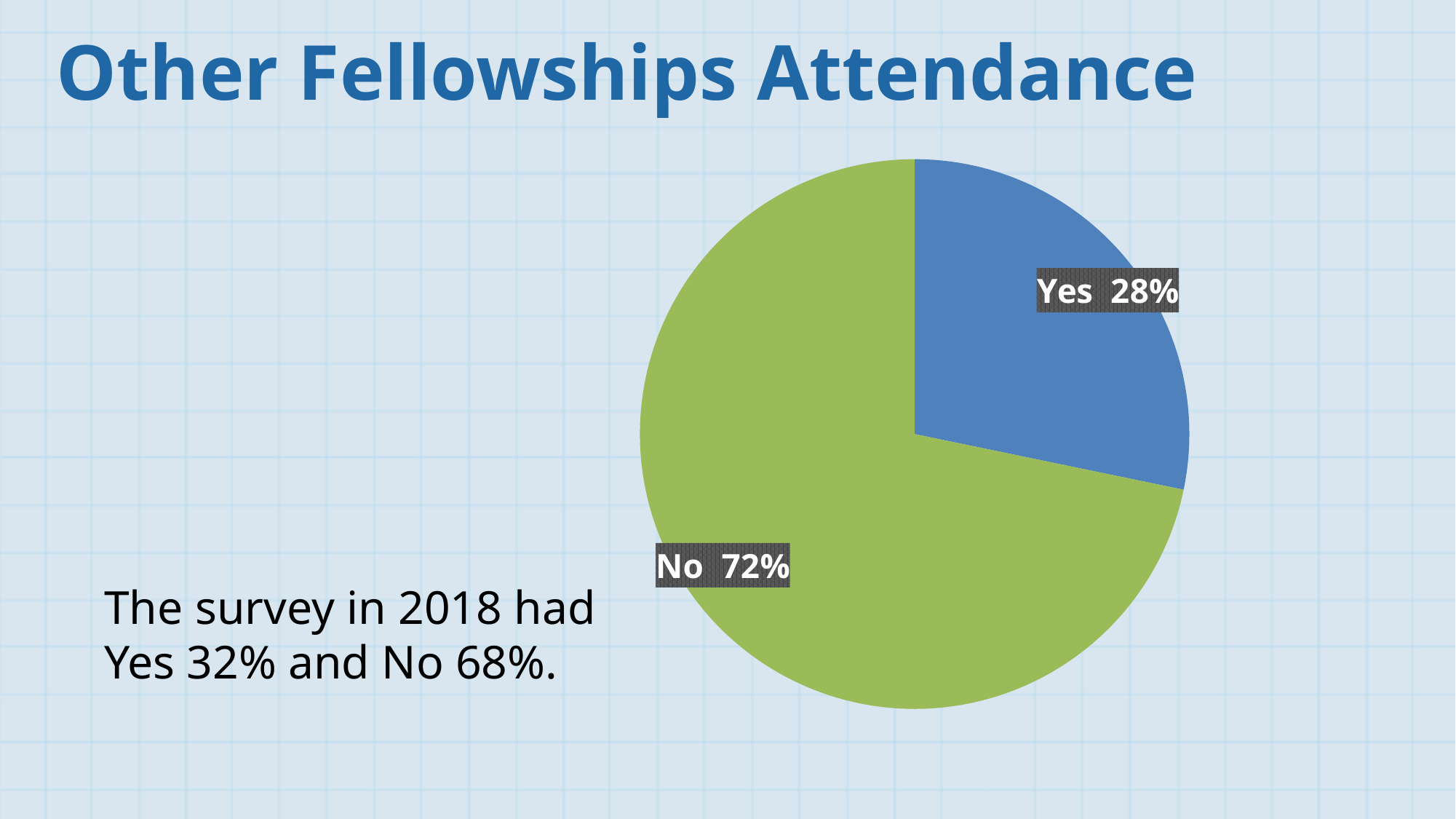
What colour is the "Yes" slice of the pie chart? blue What type of chart is shown on the slide? pie chart What share of the pie does the "No" slice represent? 72% What is the title of the slide containing the pie chart? Other Fellowships Attendance Which is larger, the "Yes" slice or the "No" slice? No What percentage of the pie is labelled "No"? 72% Which slice of the pie is the smallest? Yes Which slice of the pie is the largest? No How many slices does the pie chart have? 2 What percentage of the pie is labelled "Yes"? 28% What is the difference in percentage points between the "No" slice and the "Yes" slice? 44